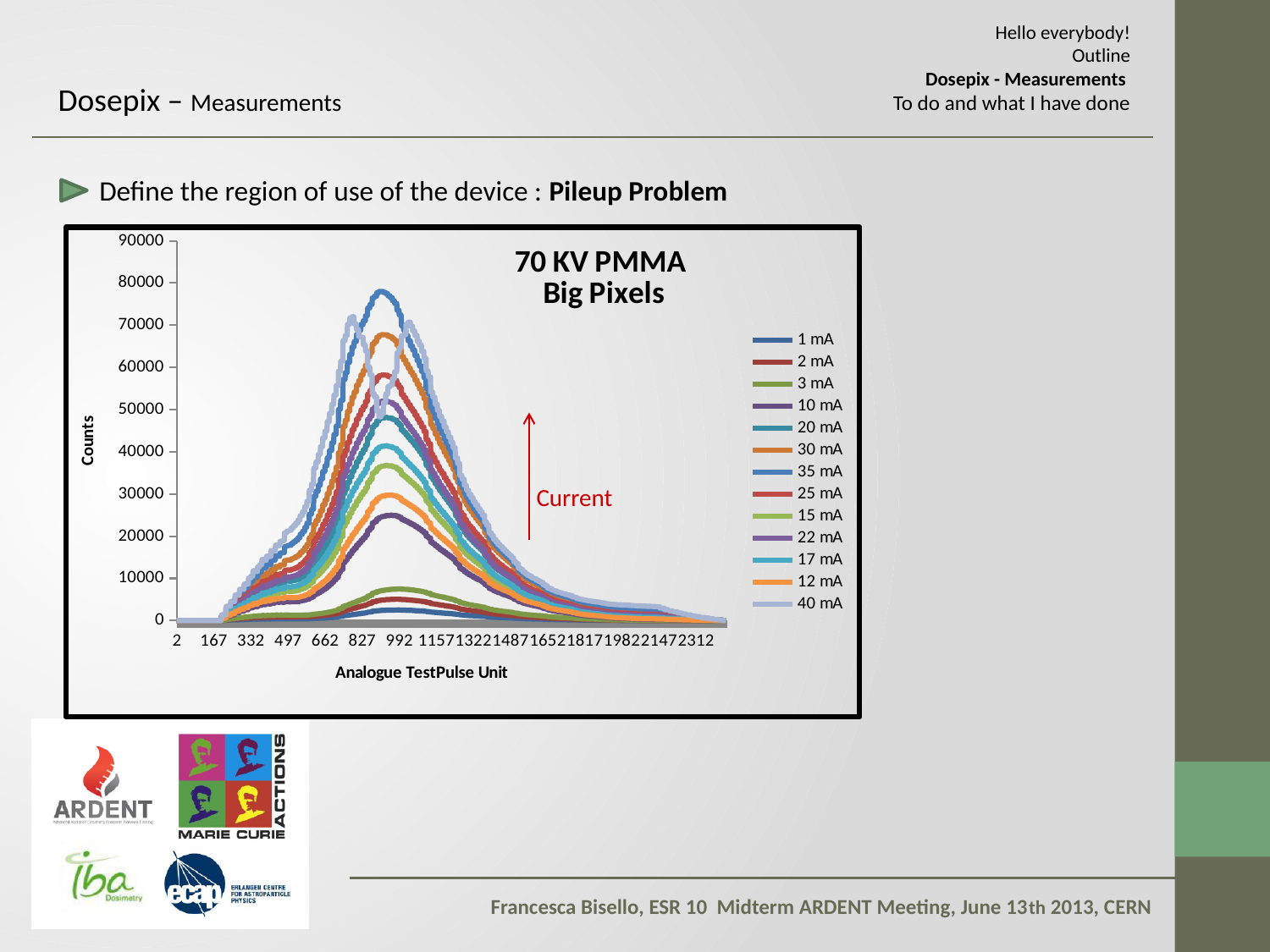
How many tick labels are printed along the x axis? 15 What is the title printed inside the chart? 70 KV PMMA Big Pixels What is the label of the vertical axis? Counts What is the first tick label on the x axis? 2 What kind of chart is shown on the slide? line chart Is the peak value of the 40 mA curve greater or less than 60000? greater Is the peak value of the 40 mA curve greater or less than 80000? less Is the highest peak reached by any curve greater or less than 70000? greater Do the curves rise or fall along the x axis after the x value 992? fall What is the highest value shown on the y axis? 90000 What is the last tick label on the x axis? 2312 How many series does the legend list? 13